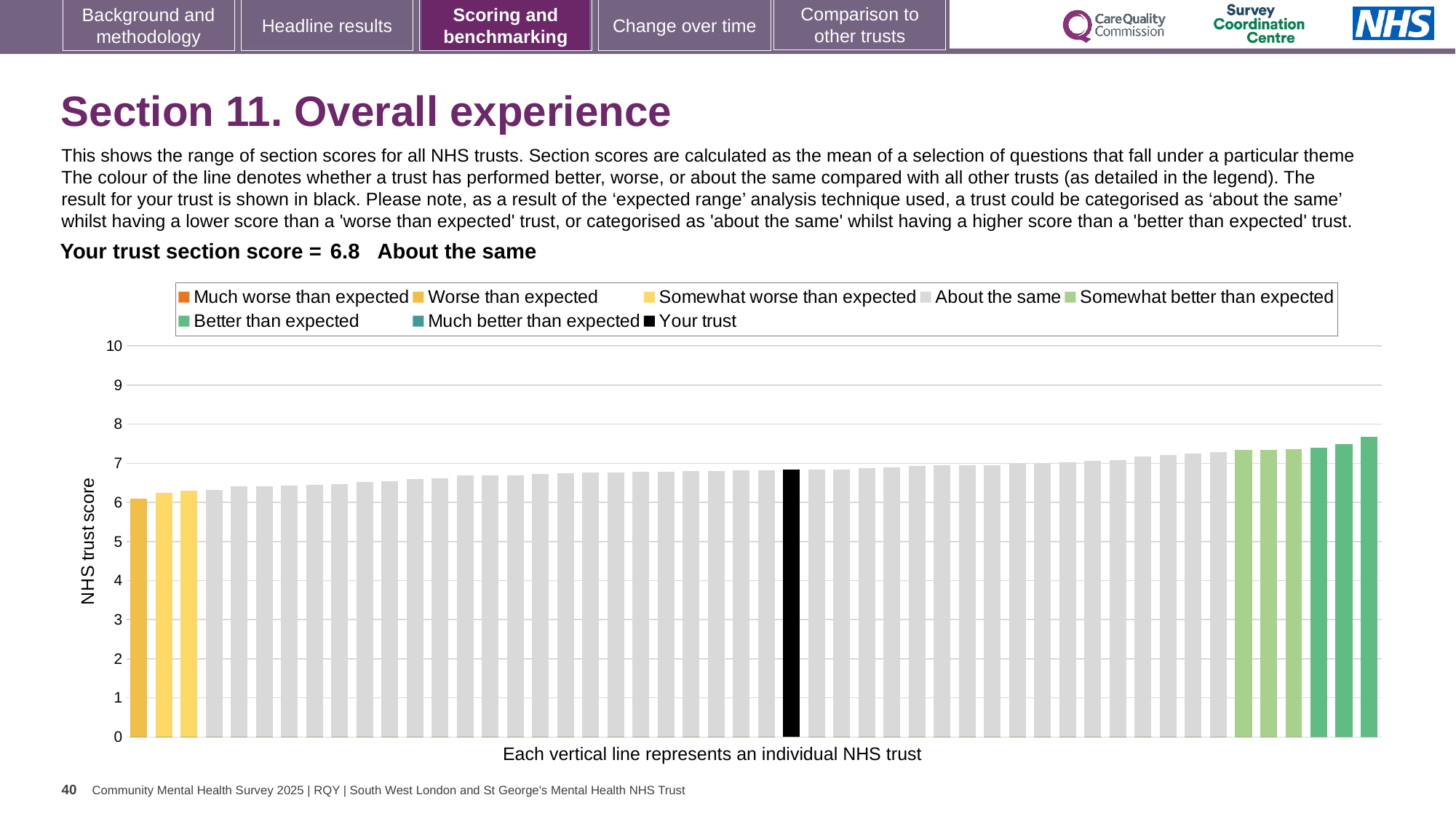
Is the value for your trust (the black bar) greater or less than 6? greater What is the section score for your trust shown on the slide? 6.8 Is the value of the lowest bar (leftmost trust) greater or less than 5? greater Is the value of the lowest bar (leftmost trust) greater or less than 7? less What kind of chart is shown on the slide? bar chart Which performance category is your trust placed in for Section 11? About the same What colour is used for the bar representing your trust? black Which legend category do the highest bars on the right of the chart belong to? Better than expected Do the bar values rise or fall moving from left to right along the x axis? rise How many entries does the chart legend list? 8 What is the label on the vertical axis of the chart? NHS trust score